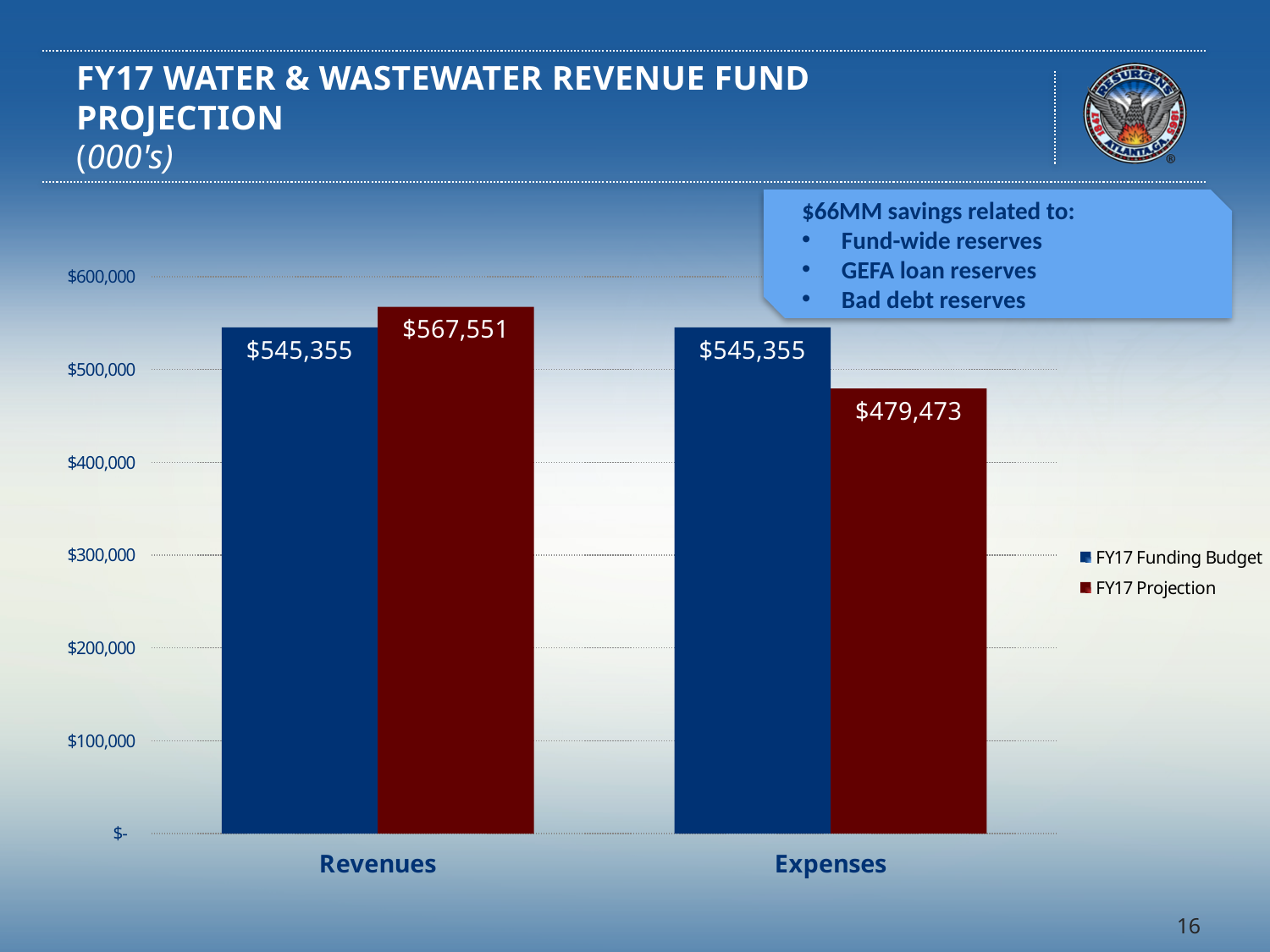
Which bar on the chart has the highest value? FY17 Projection for Revenues Which bar on the chart has the lowest value? FY17 Projection for Expenses What is the FY17 Projection value for Revenues? $567,551 What is the difference between the FY17 Funding Budget and the FY17 Projection for Expenses? $65,882 How many series does the legend list? 2 What is the difference between the FY17 Projection and the FY17 Funding Budget for Revenues? $22,196 What is the FY17 Funding Budget value for Expenses? $545,355 How many categories are shown on the x axis? 2 What is the FY17 Projection value for Expenses? $479,473 What kind of chart is shown on the slide? Bar chart For Expenses, which is larger: the FY17 Funding Budget or the FY17 Projection? FY17 Funding Budget What is the FY17 Funding Budget value for Revenues? $545,355